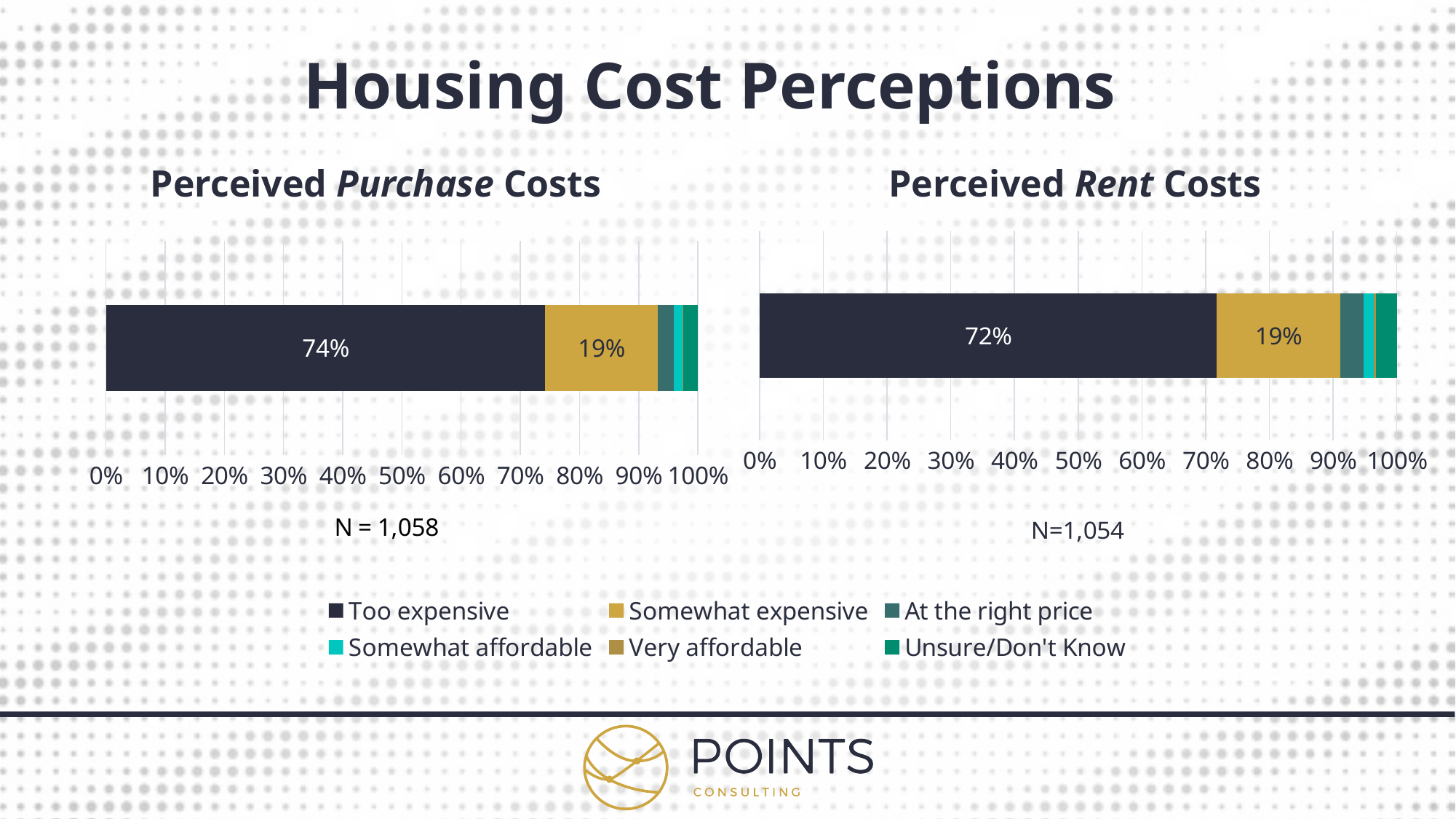
In the Perceived Purchase Costs chart, what percentage of respondents said housing is Too expensive? 74% Which response category has the largest share in the Perceived Purchase Costs chart? Too expensive In the Perceived Rent Costs chart, what percentage of respondents said rent is Too expensive? 72% What is the sample size (N) shown under the Perceived Rent Costs chart? N=1,054 In the Perceived Purchase Costs chart, is the value for At the right price greater or less than 10%? less What is the difference between the Too expensive share in the Perceived Purchase Costs chart and the Too expensive share in the Perceived Rent Costs chart? 2 percentage points Which response category has the largest share in the Perceived Rent Costs chart? Too expensive How many series does the legend list? 6 Is the Too expensive share larger in the Perceived Purchase Costs chart or the Perceived Rent Costs chart? Perceived Purchase Costs In the Perceived Purchase Costs chart, what percentage of respondents said housing is Somewhat expensive? 19% What kind of chart is used for Perceived Purchase Costs? Stacked horizontal bar chart In the Perceived Rent Costs chart, what percentage of respondents said rent is Somewhat expensive? 19%